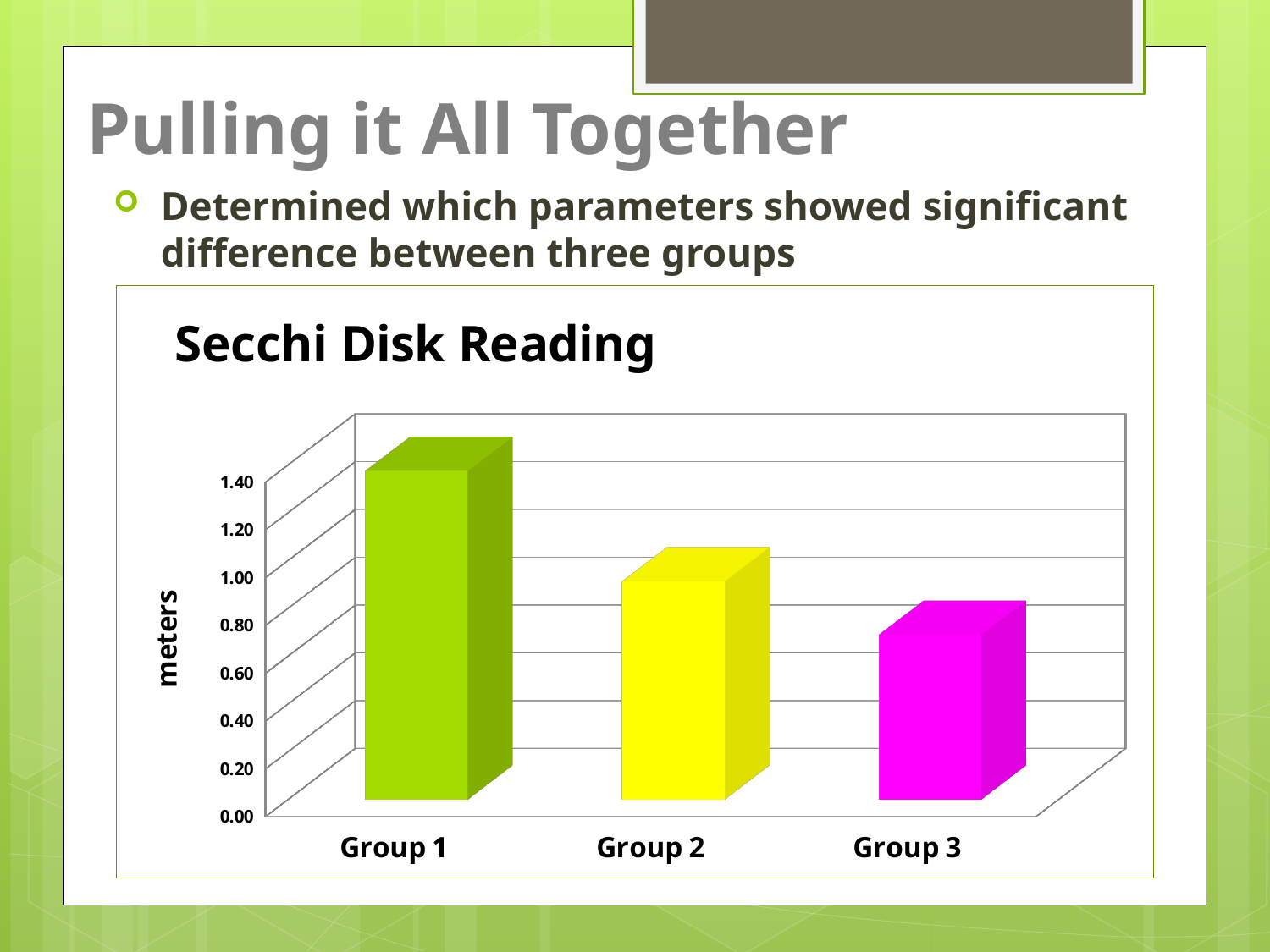
Which group has the highest Secchi disk reading? Group 1 Which has a larger Secchi disk reading, Group 1 or Group 2? Group 1 What is the title of the chart? Secchi Disk Reading Which has a larger Secchi disk reading, Group 2 or Group 3? Group 2 Is the value for Group 1 greater or less than 1.20? greater Is the value for Group 2 greater or less than 1.20? less Which group has the lowest Secchi disk reading? Group 3 How many groups are plotted in the chart? 3 Do the Secchi disk readings rise or fall from Group 1 to Group 3? fall What is the label on the vertical axis of the chart? meters What kind of chart is shown on the slide? bar chart Is the value for Group 3 greater or less than 1.00? less